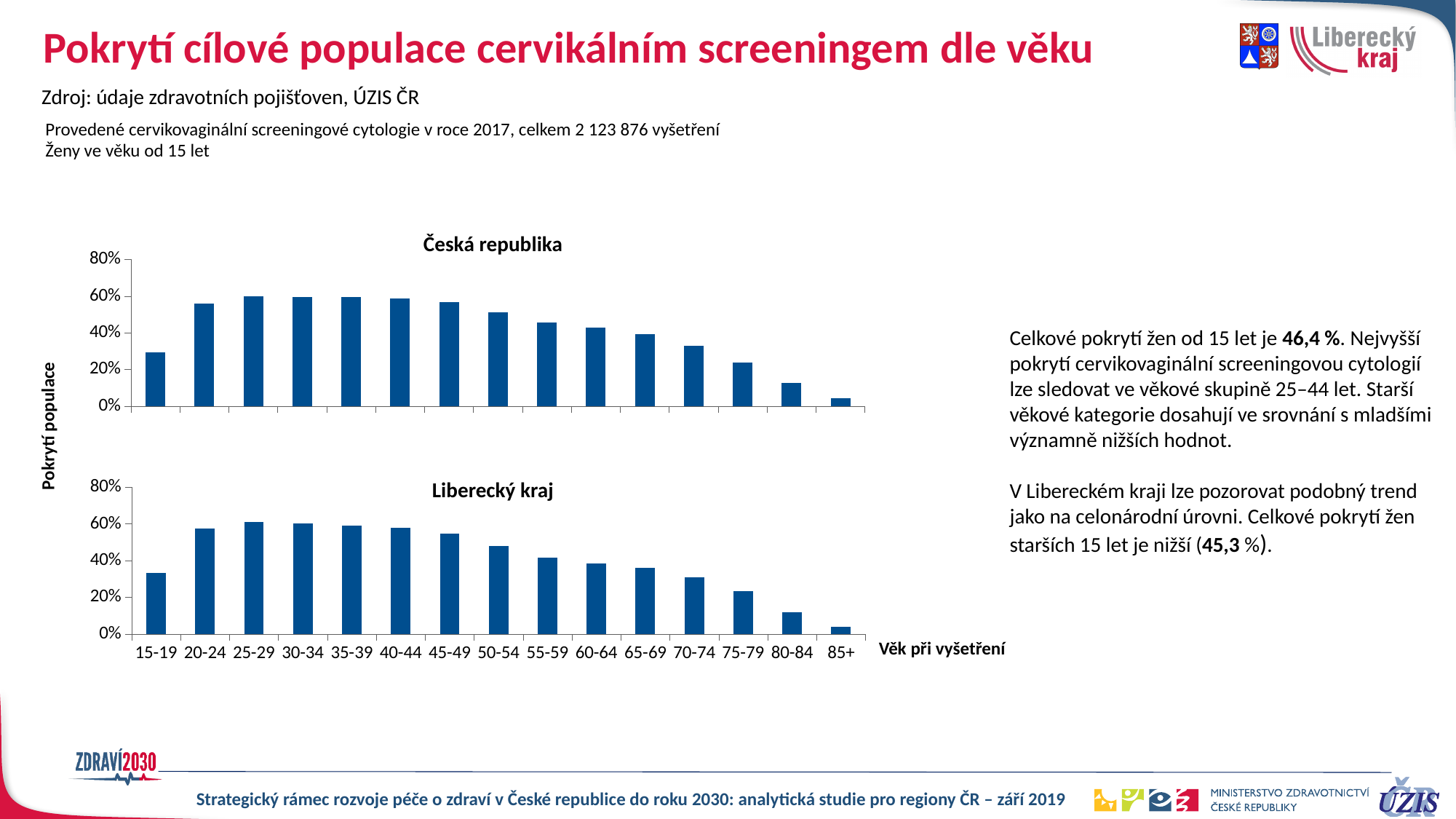
What is the label of the x axis shared by the two charts? Věk při vyšetření In the "Liberecký kraj" chart, do the values rise or fall from the 25-29 age group to the 85+ age group? fall In the "Česká republika" chart, is the value for 50-54 greater or less than 40%? greater In the "Liberecký kraj" chart, is the value for 70-74 greater or less than 20%? greater In the "Česká republika" chart, is the value for 80-84 greater or less than 20%? less In the "Česká republika" chart, which age group has the lowest value? 85+ In the "Liberecký kraj" chart, which age group has the lowest value? 85+ How many age categories are shown on the x axis of the "Liberecký kraj" chart? 15 In the "Česká republika" chart, which is larger, the value for 20-24 or the value for 70-74? 20-24 What kind of chart is the "Česká republika" chart? bar chart